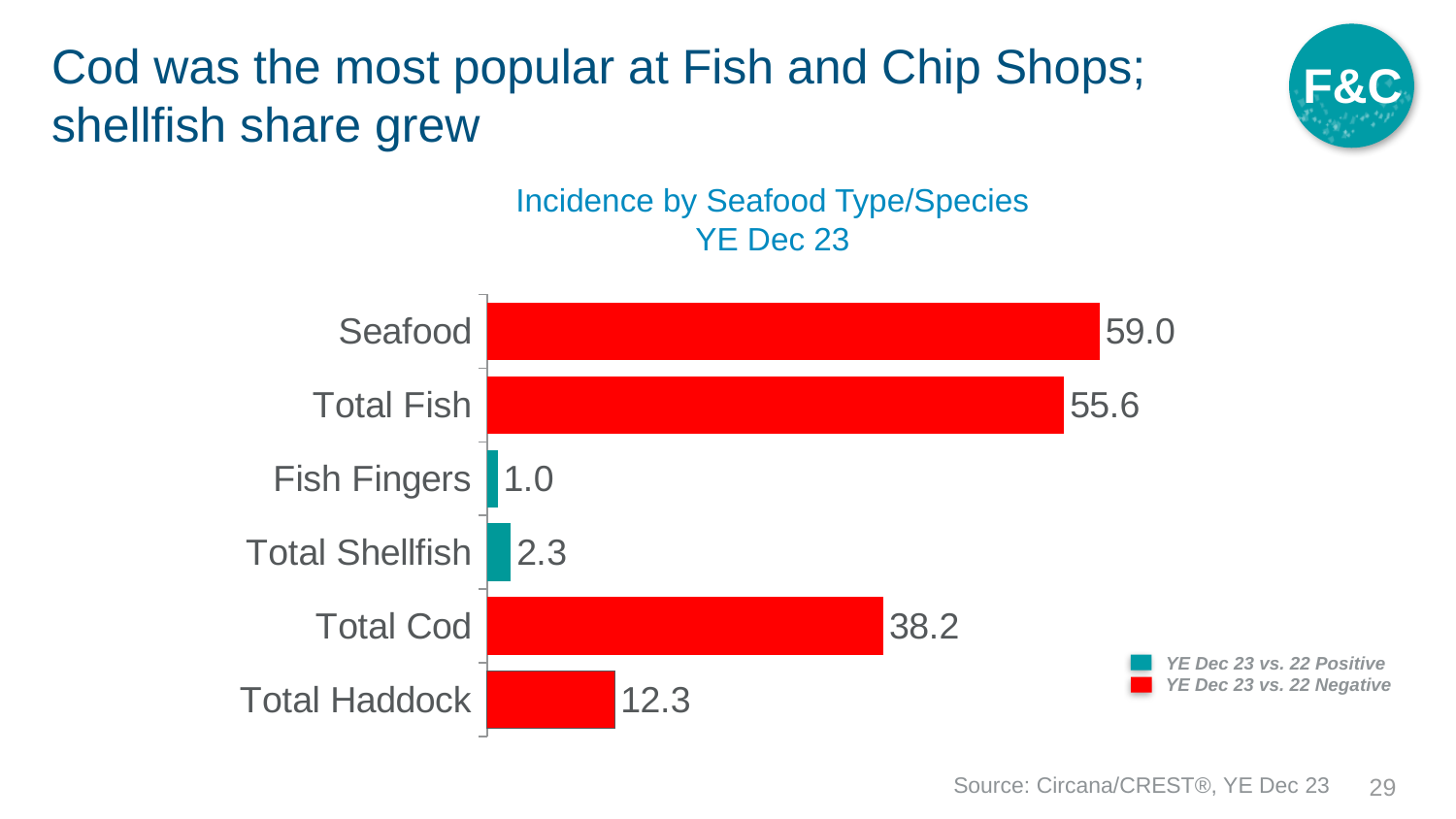
What is the value for Total Shellfish? 2.3 What is the difference between Seafood and Total Fish? 3.4 What does the teal colour in the legend represent? YE Dec 23 vs. 22 Positive What is the difference between Total Cod and Total Haddock? 25.9 What is the value for Seafood? 59.0 Which category has the highest value? Seafood Which is larger, Total Cod or Total Haddock? Total Cod Which category has the lowest value? Fish Fingers What kind of chart is shown on the slide? Bar chart What is the value for Total Cod? 38.2 How many categories are shown in the chart? 6 What is the value for Total Haddock? 12.3